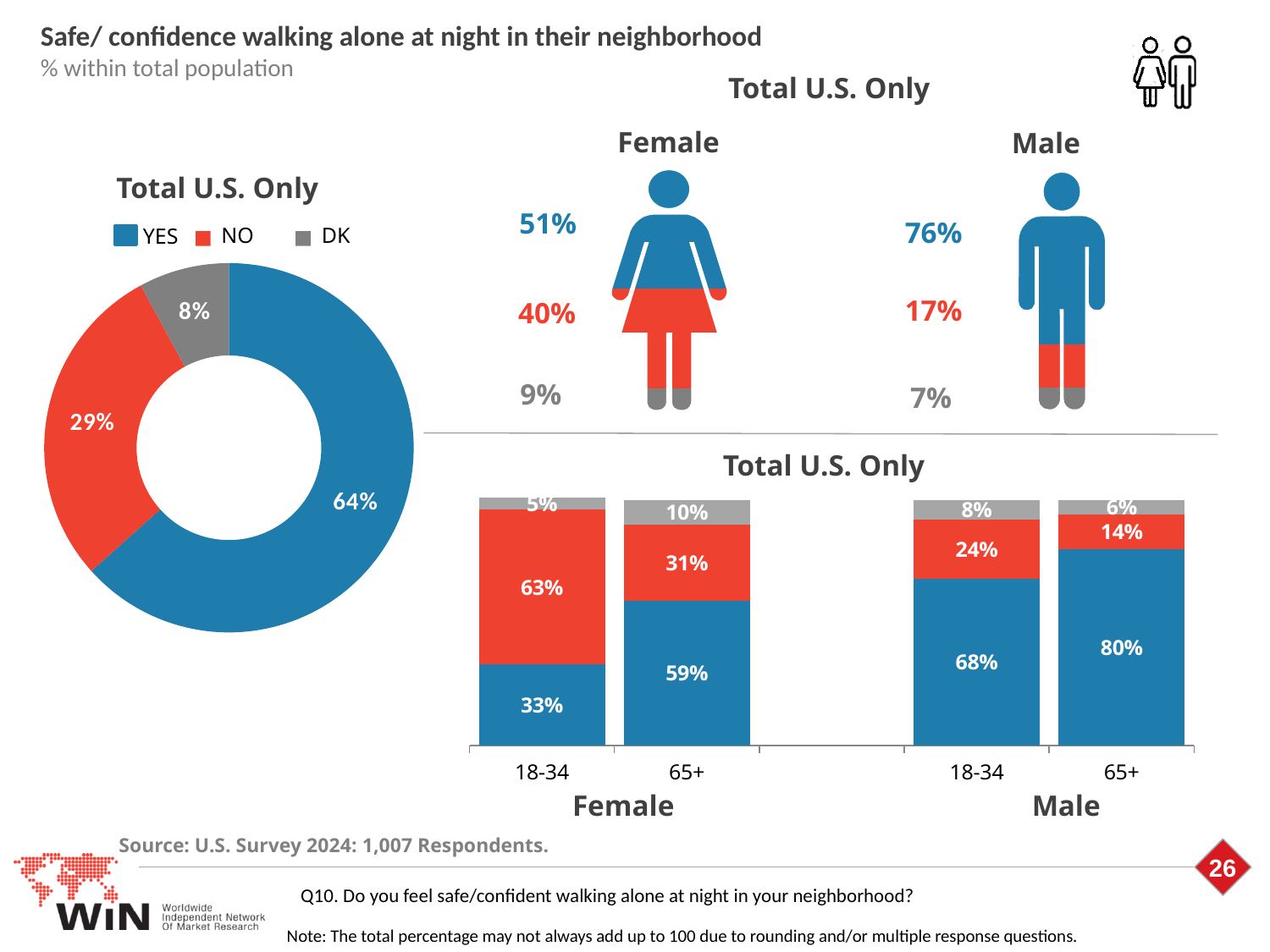
In the stacked bar chart at the bottom, what is the blue (YES) value for Female 18-34? 33% In the Female/Male pictogram chart, which group has the higher YES percentage, Female or Male? Male In the donut chart on the left, what percentage answered DK? 8% In the donut chart on the left, how many series does the legend list? 3 In the donut chart on the left, what is the difference between the YES and NO percentages? 35% In the stacked bar chart at the bottom, which group has the highest blue (YES) value? Male 65+ In the donut chart on the left, what percentage answered YES? 64% What type of chart is shown at the bottom of the slide? Stacked bar chart In the donut chart on the left, which response has the smallest share? DK In the stacked bar chart at the bottom, what is the red (NO) value for Male 65+? 14% In the Female/Male pictogram chart, what percentage of males answered YES (blue)? 76% In the Female/Male pictogram chart, what percentage of females answered NO (red)? 40%